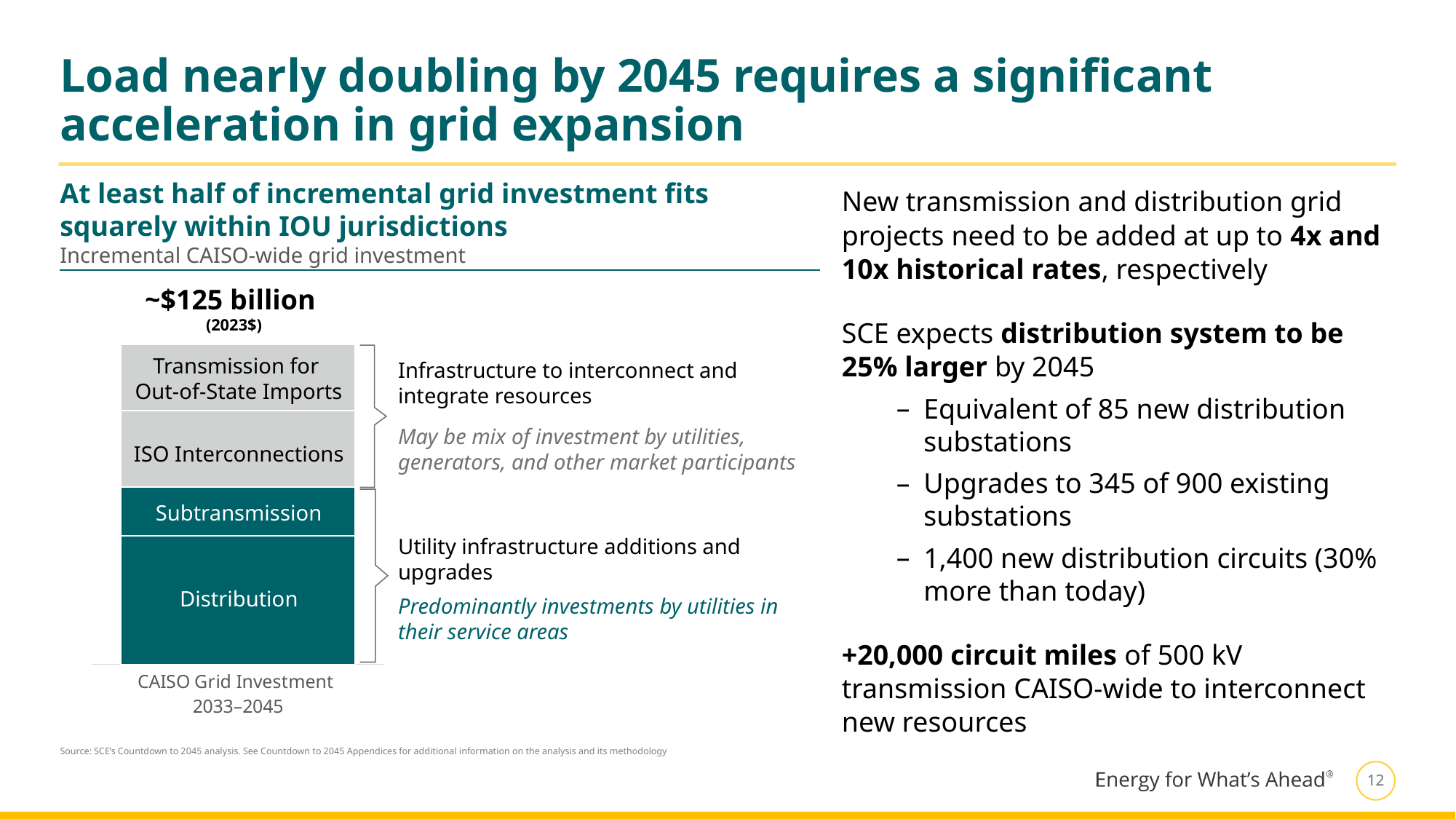
Which segment sits at the top of the stacked bar? Transmission for Out-of-State Imports What kind of chart is shown on the slide? Stacked bar chart Which segments of the stacked bar are shaded dark teal? Subtransmission and Distribution How many segments make up the stacked bar in the chart? 4 What total value is printed above the stacked bar? ~$125 billion Which segment sits at the bottom of the stacked bar? Distribution Which segment of the stacked bar is the largest? Distribution Which segment is larger, Distribution or ISO Interconnections? Distribution In what dollar basis is the ~$125 billion total expressed, according to the label under it? 2023$ Which segment is larger, Transmission for Out-of-State Imports or Subtransmission? Transmission for Out-of-State Imports What is the label under the stacked bar on the x axis? CAISO Grid Investment 2033–2045 Which segment of the stacked bar is the smallest? Subtransmission